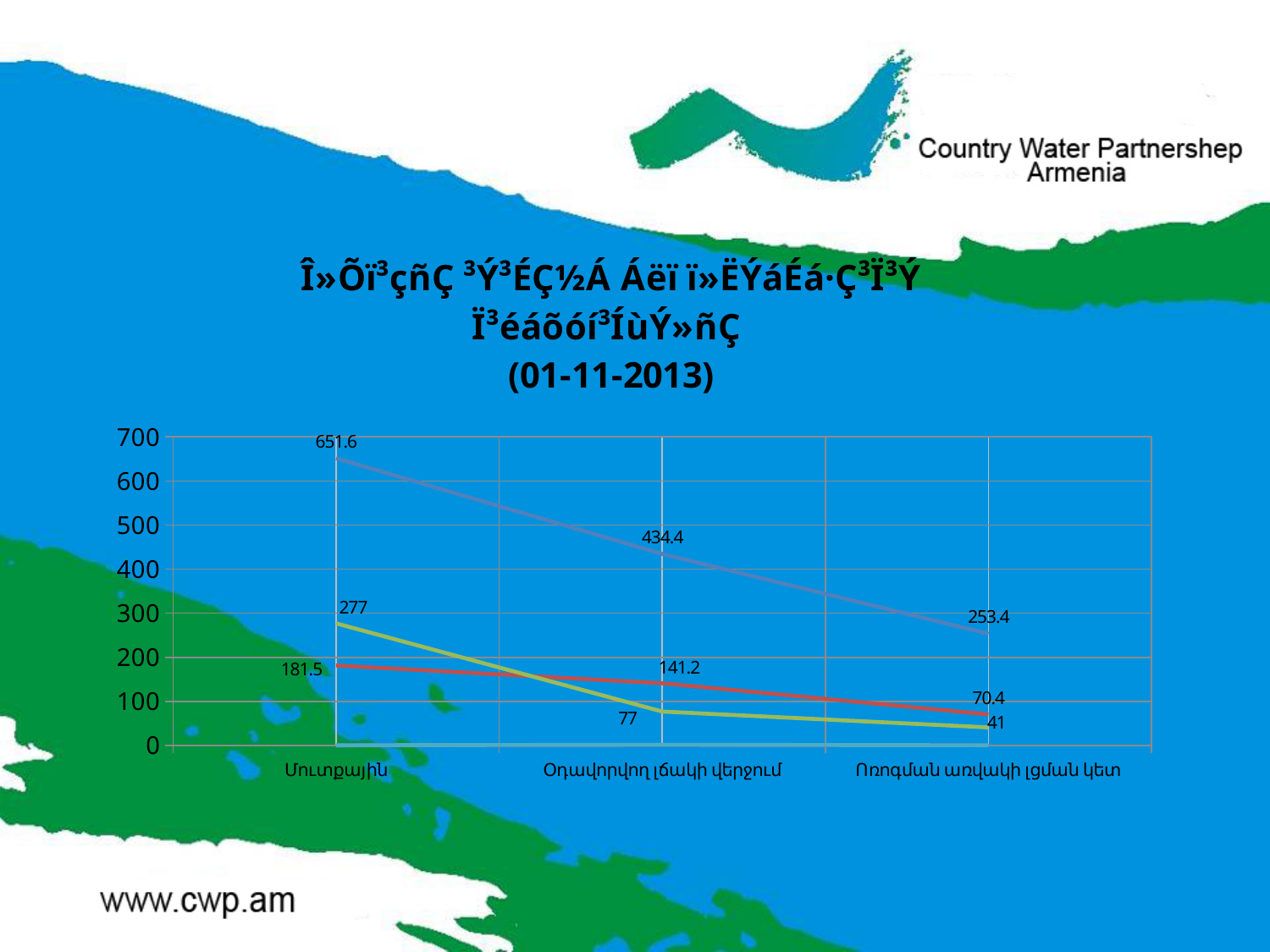
What is the value of the grey line for the third category (Ոռոգման առվակի լցման կետ)? 253.4 For the second category (Օգտավորվող լճակի վերջում), which is larger: the red line value or the yellow line value? red line (141.2) What is the difference between the grey line's values for the first and third categories (651.6 and 253.4)? 398.2 What is the value of the grey line for the second category (Օգտավորվող լճակի վերջում)? 434.4 Do the values of the grey line rise or fall from left to right along the x axis? fall What kind of chart is shown on the slide? line chart How many categories are shown along the x axis of the chart? 3 What is the highest value plotted on the chart? 651.6 What is the value of the yellow line for the first category (Մուտքային)? 277 What is the value of the red line for the third category (Ոռոգման առվակի լցման կետ)? 70.4 What is the value of the grey line for the first category (Մուտքային)? 651.6